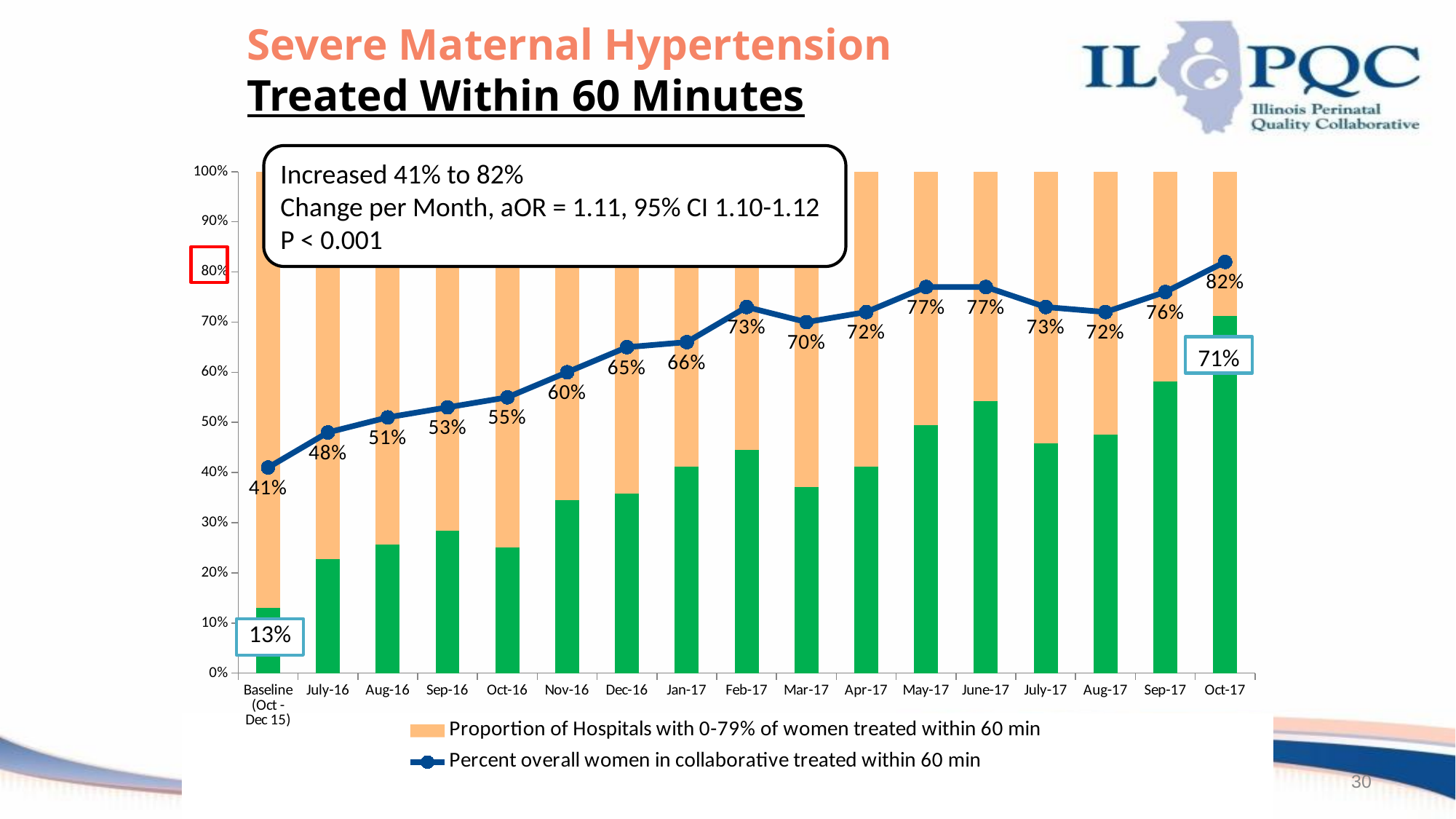
What is the percent overall women in collaborative treated within 60 min in Feb-17? 73% In which month is the percent overall women treated within 60 min the highest? Oct-17 Is the green bar for Sep-17 greater or less than 50%? greater Which is larger, the percent overall women treated within 60 min in Mar-17 or in Feb-17? Feb-17 How many series does the legend list? 2 What is the difference between the percent overall women treated within 60 min in Oct-17 and at Baseline? 41% What value is labeled on the green bar for Oct-17? 71% What is the percent overall women in collaborative treated within 60 min in Oct-17? 82% What is the percent overall women in collaborative treated within 60 min at Baseline (Oct - Dec 15)? 41% Which period has the lowest percent overall women treated within 60 min? Baseline (Oct - Dec 15) What value is labeled on the green bar for Baseline (Oct - Dec 15)? 13% How many time periods are shown on the x axis? 17